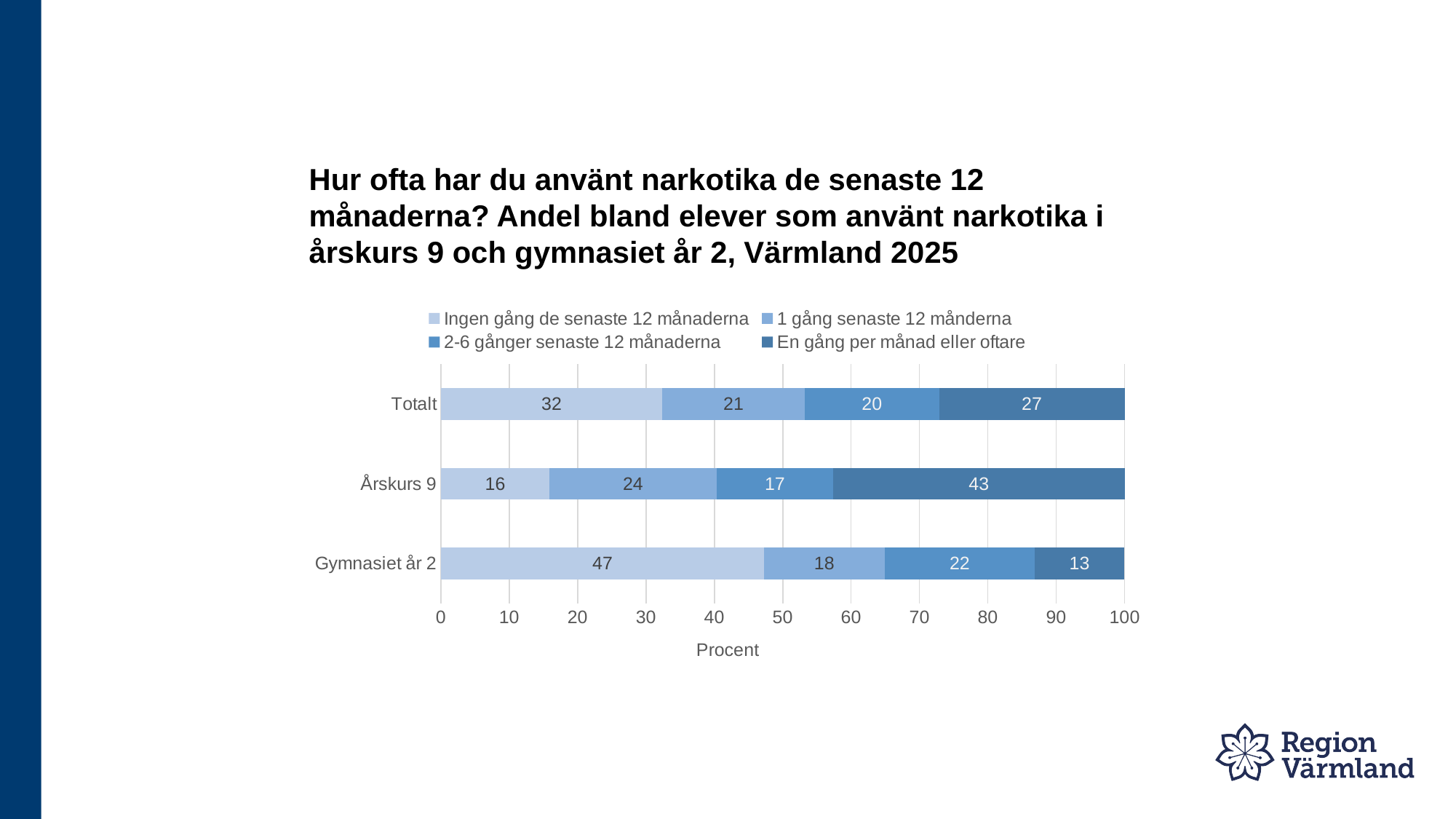
What kind of chart is shown on the slide? Stacked bar chart What is the total of the stacked bar for Totalt? 100 What is the value for '1 gång senaste 12 månderna' for Totalt? 21 Which is larger: the 'En gång per månad eller oftare' value for Totalt or for Gymnasiet år 2? Totalt What is the value for '2-6 gånger senaste 12 månaderna' for Gymnasiet år 2? 22 What is the value for 'En gång per månad eller oftare' for Årskurs 9? 43 Which category has the lowest value for 'Ingen gång de senaste 12 månaderna'? Årskurs 9 Which category has the highest value for 'En gång per månad eller oftare'? Årskurs 9 What is the difference between the 'Ingen gång de senaste 12 månaderna' values for Gymnasiet år 2 and Årskurs 9? 31 How many series does the legend list? 4 How many categories are shown on the y axis? 3 What is the value for 'Ingen gång de senaste 12 månaderna' for Gymnasiet år 2? 47